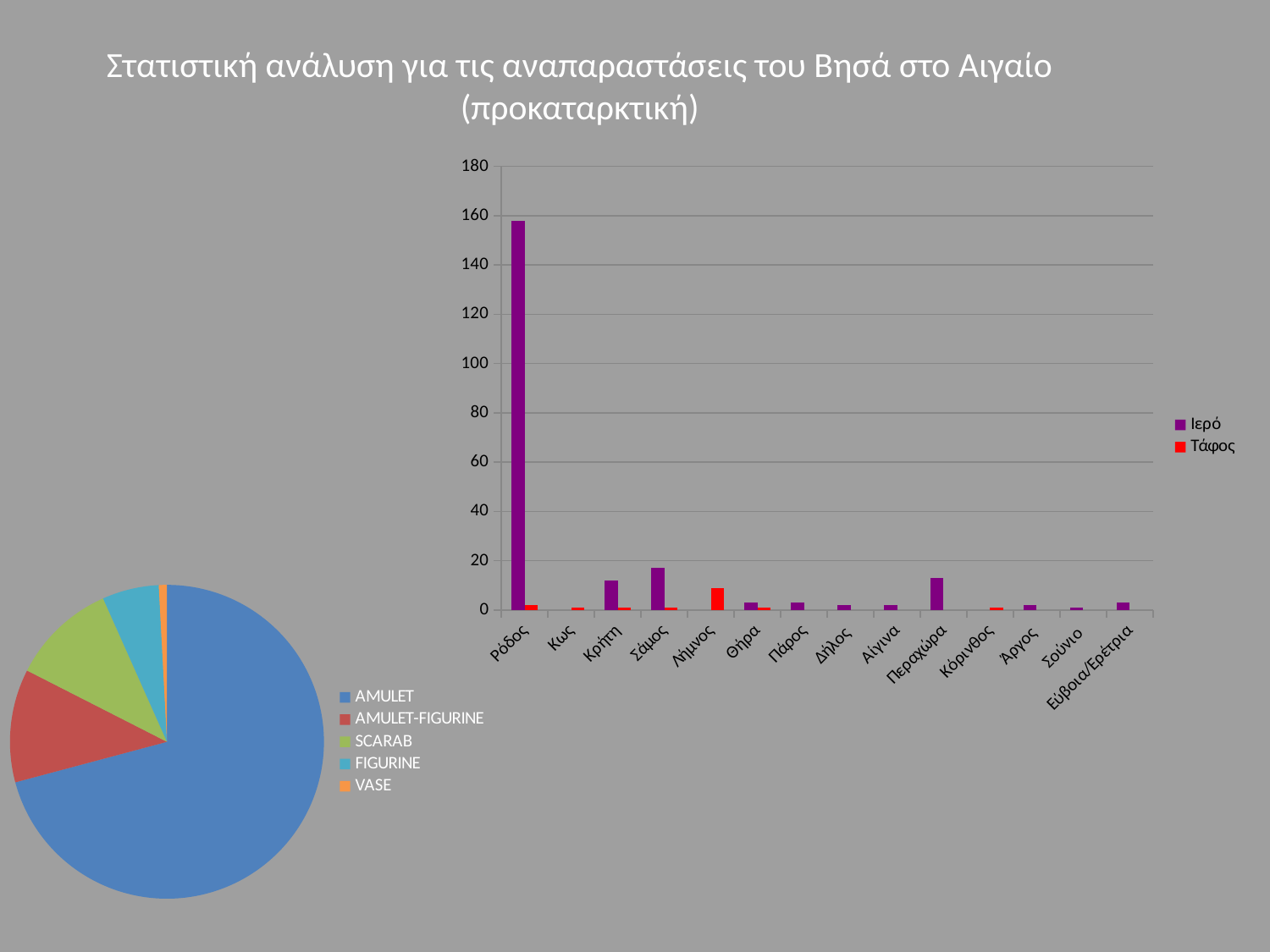
What kind of chart is the chart at the bottom left of the slide? pie chart In the pie chart at the bottom left, which category has the smallest slice? VASE In the bar chart on the right, which location has the highest value for Ιερό? Ρόδος In the pie chart at the bottom left, how many slices does the legend list? 5 In the pie chart at the bottom left, which category has the largest slice? AMULET In the bar chart on the right, which location has the highest value for Τάφος? Λήμνος In the bar chart on the right, is the Ιερό value for Σάμος greater or less than 20? less In the bar chart on the right, how many location categories are shown on the x axis? 14 In the bar chart on the right, how many series does the legend list? 2 In the bar chart on the right, is the Ιερό value for Ρόδος greater or less than 140? greater What kind of chart is the chart on the right of the slide? bar chart In the bar chart on the right, which has the larger Ιερό value, Σάμος or Κρήτη? Σάμος